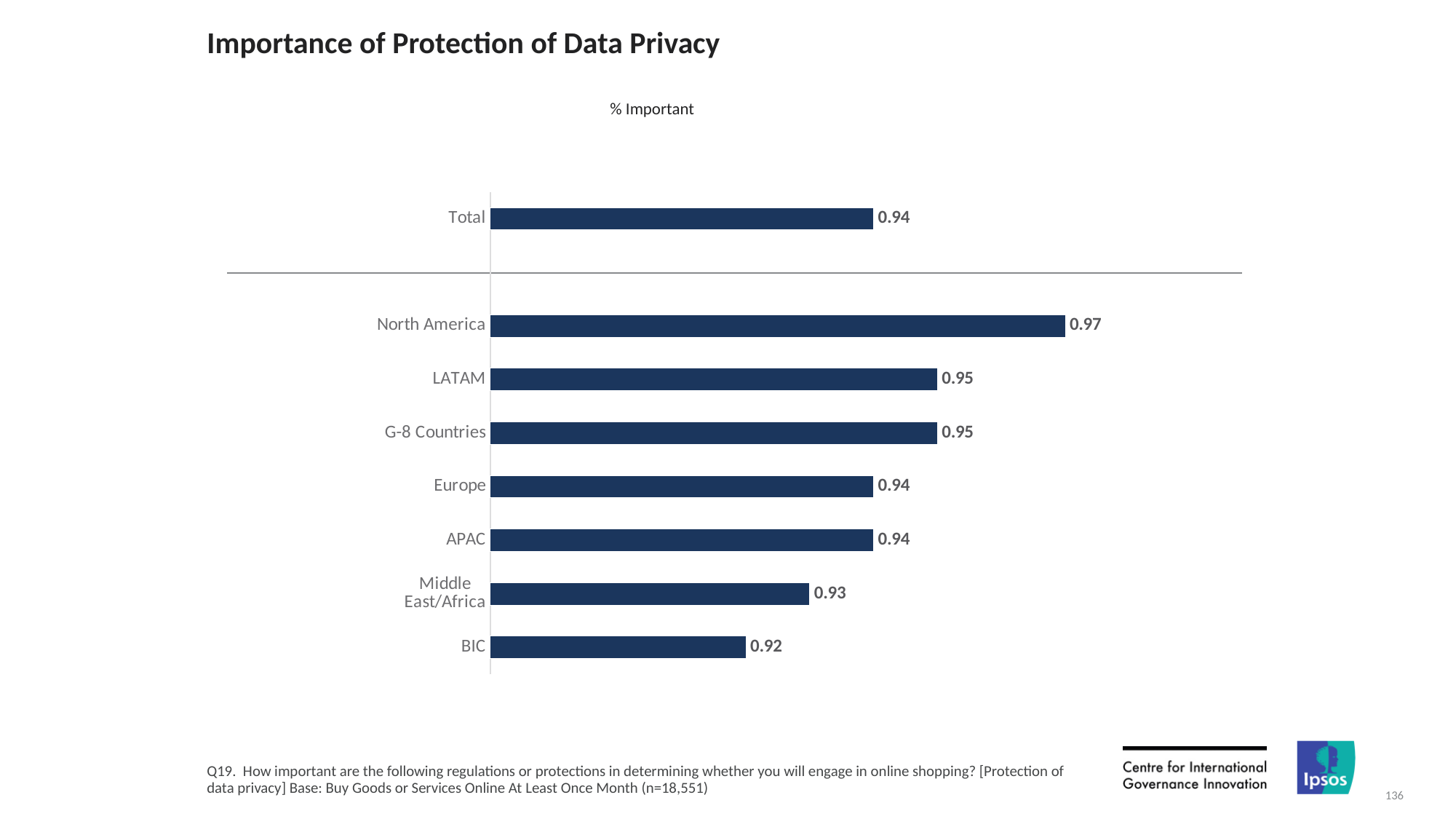
Which region has the lowest value? BIC Which region has the highest value? North America What kind of chart is shown on the slide? Bar chart What is the value for Middle East/Africa? 0.93 What is the value for North America? 0.97 Which is larger, the value for LATAM or the value for Middle East/Africa? LATAM What is the title of the chart? % Important What is the value for Total? 0.94 What is the difference between the values for North America and BIC? 0.05 What is the value for BIC? 0.92 How many bars are plotted on the chart? 8 What is the value for LATAM? 0.95